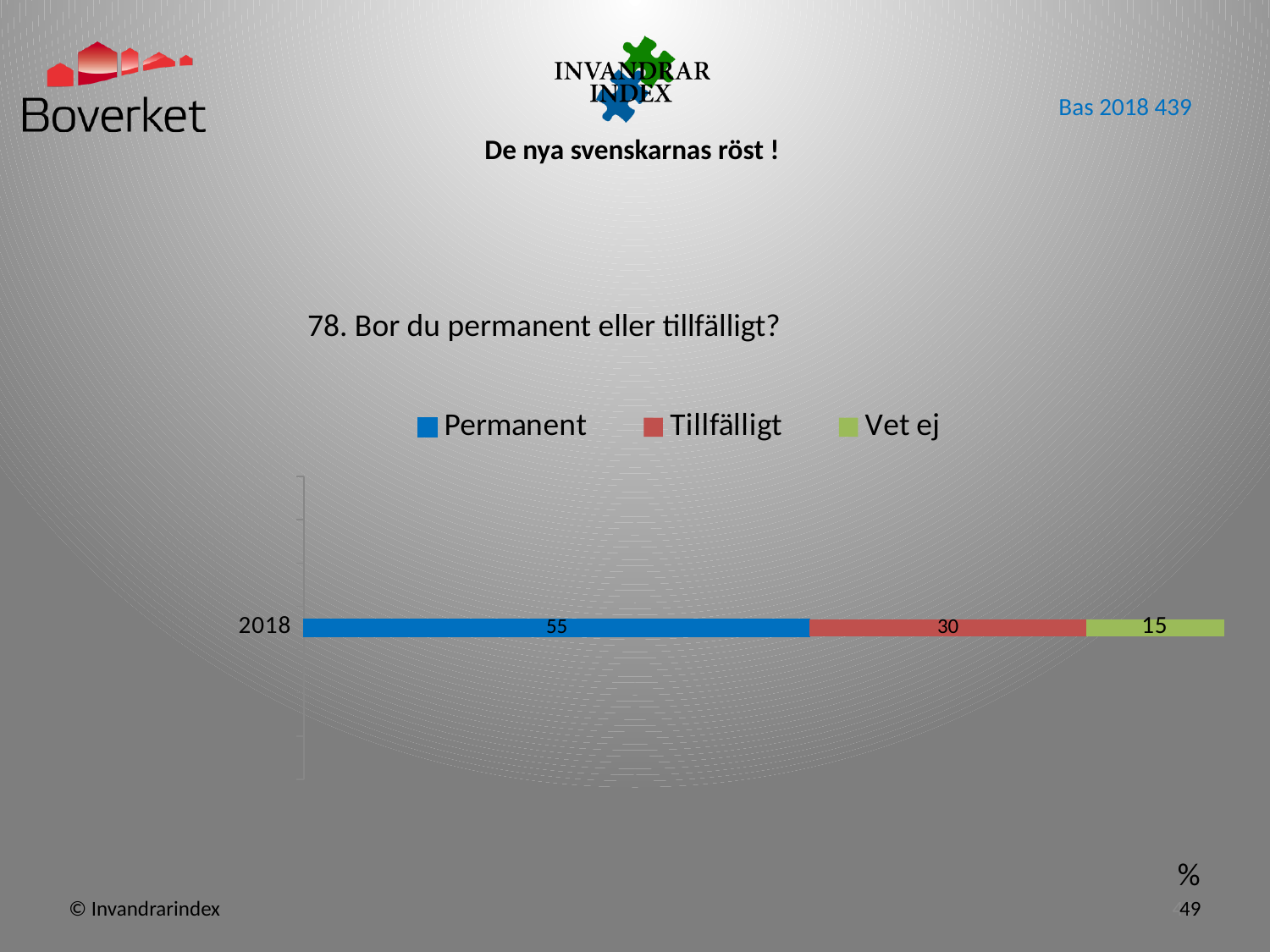
What is the total of the stacked bar for 2018? 100 What is the difference between the Permanent and Tillfälligt values in 2018? 25 What is the value for Permanent in 2018? 55 How many series does the legend list? 3 What is the difference between the Tillfälligt and Vet ej values in 2018? 15 What is the title of the chart? 78. Bor du permanent eller tillfälligt? Which series has the lowest value in 2018? Vet ej What is the value for Tillfälligt in 2018? 30 Which series has the highest value in 2018? Permanent What is the value for Vet ej in 2018? 15 Which is larger in 2018, Tillfälligt or Vet ej? Tillfälligt What kind of chart is shown on the slide? Stacked bar chart